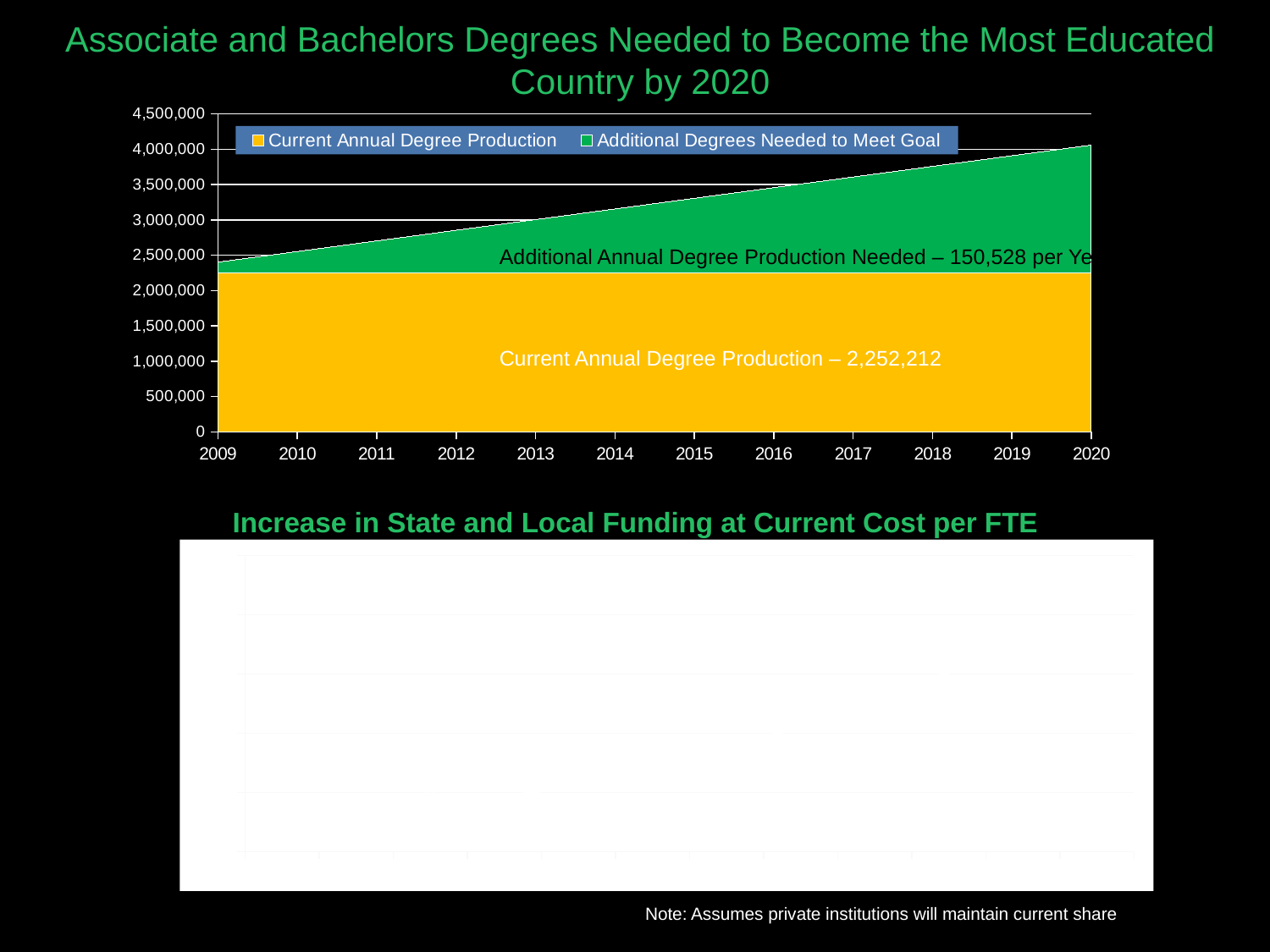
In the top chart, is the total degree production in 2009 greater or less than 2,500,000? less In the top chart, which year has the lowest total degree production? 2009 In the top chart, in 2020, which series is larger: Current Annual Degree Production or Additional Degrees Needed to Meet Goal? Current Annual Degree Production In the top chart, is the total degree production in 2020 greater or less than 3,500,000? greater In the top chart, what is the Additional Annual Degree Production Needed per year? 150,528 In the top chart, what colour represents Current Annual Degree Production? Yellow In the top chart, what is the Current Annual Degree Production value printed on the chart? 2,252,212 In the top chart, how many years are shown on the x axis? 12 In the top chart, does the Additional Degrees Needed to Meet Goal area rise or fall from 2009 to 2020? Rise In the top chart titled 'Associate and Bachelors Degrees Needed to Become the Most Educated Country by 2020', what kind of chart is shown? Stacked area chart In the top chart, how many series does the legend list? 2 In the top chart, which year has the highest total degree production? 2020